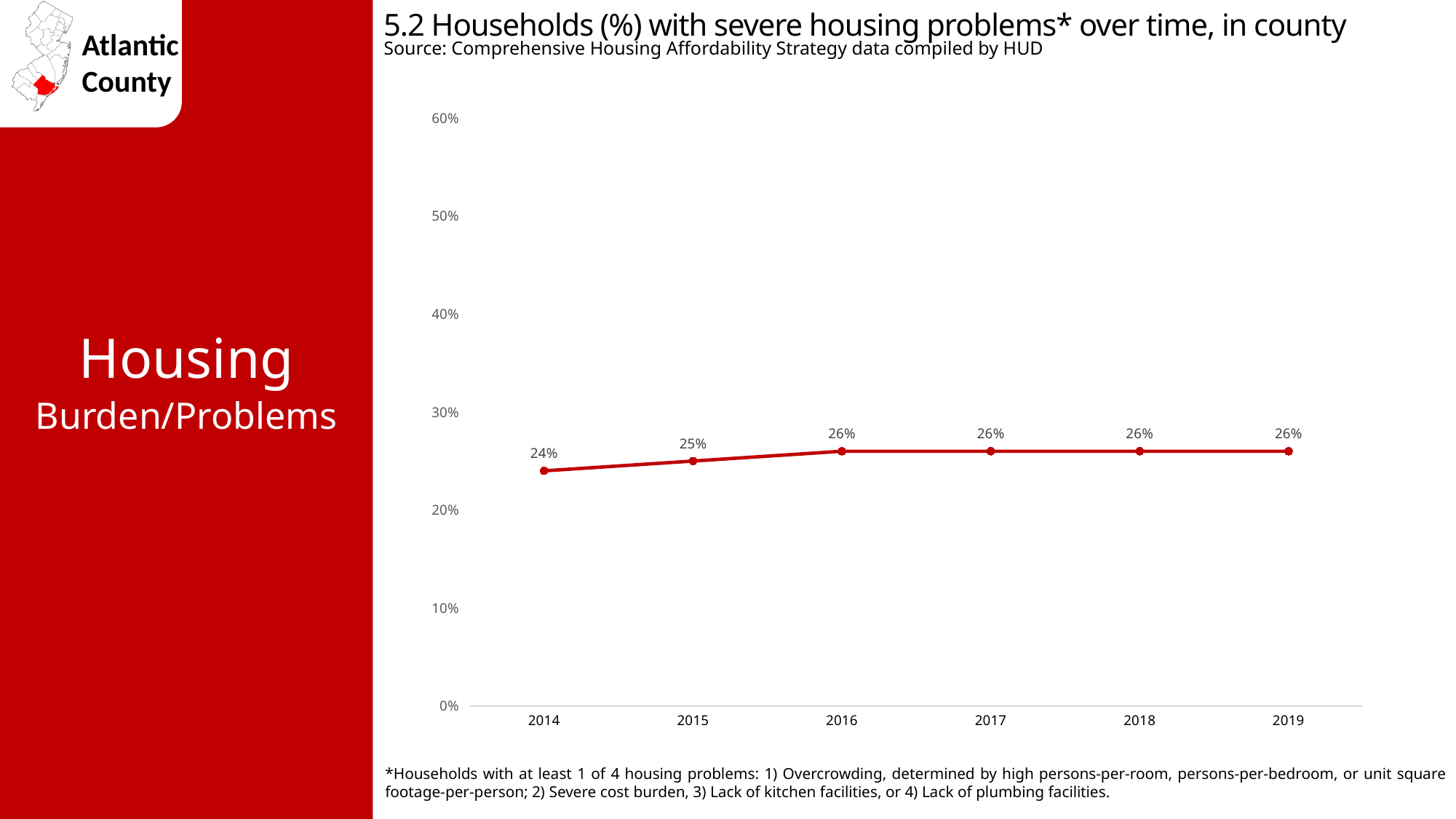
What is the highest value shown on the vertical axis? 60% Which is larger, the value for 2015 or the value for 2014? 2015 What is the source of the data shown in the chart? Comprehensive Housing Affordability Strategy data compiled by HUD What percentage of households had severe housing problems in 2014? 24% What percentage of households had severe housing problems in 2015? 25% Is the value for 2017 greater or less than 30%? less How many years are plotted on the chart? 6 What kind of chart is shown on the slide? line chart What is the difference in percentage points between 2016 and 2014? 2 Which year has the lowest percentage of households with severe housing problems? 2014 Do the values rise or fall from 2014 to 2016? rise What percentage of households had severe housing problems in 2019? 26%